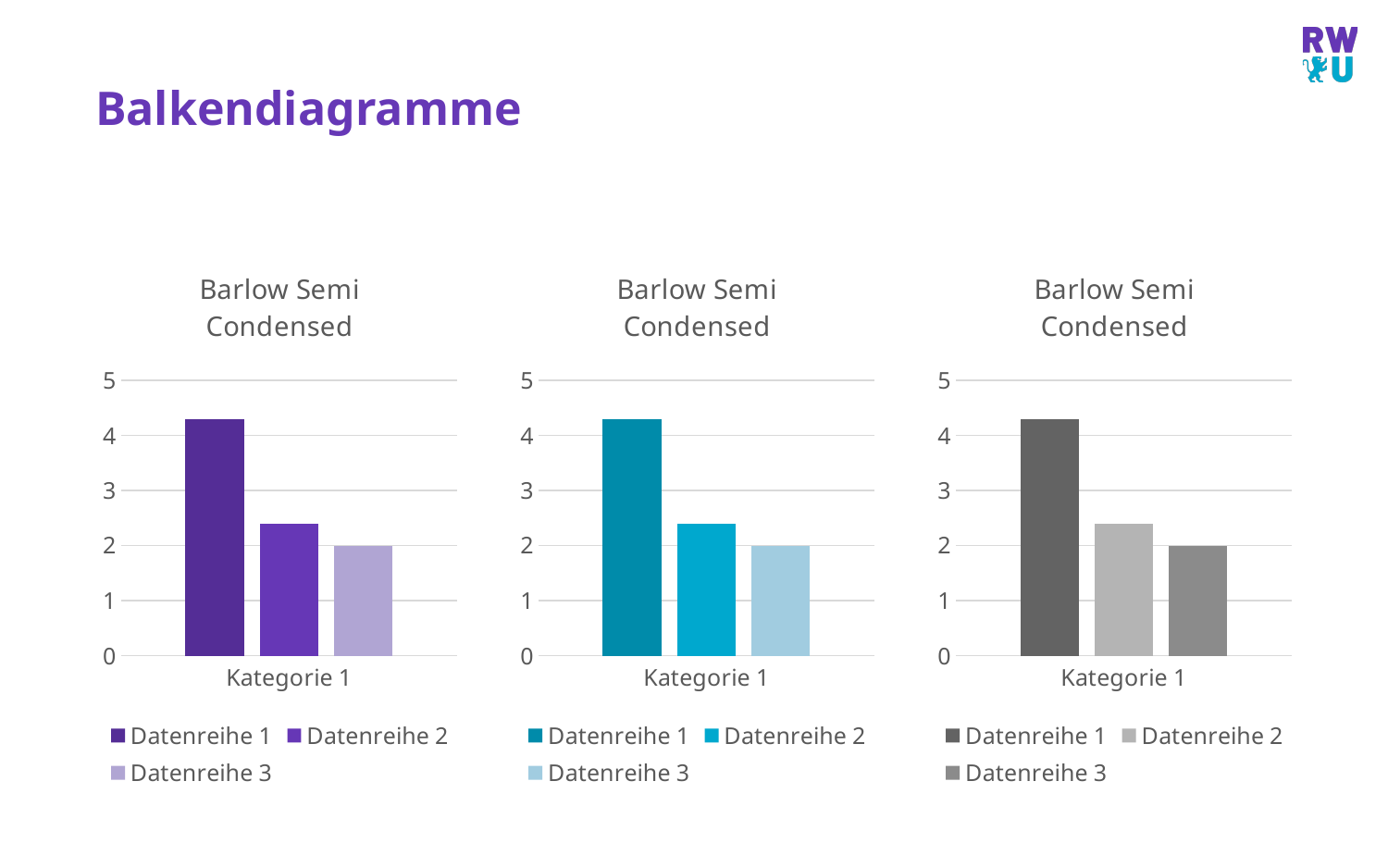
In the middle chart, which series has the lowest value for Kategorie 1? Datenreihe 3 In the left chart, which series has the highest value for Kategorie 1? Datenreihe 1 What kind of chart is the left chart on the slide? bar chart In the left chart, is the value for Datenreihe 2 greater or less than 3? less In the left chart, which is larger for Kategorie 1: Datenreihe 2 or Datenreihe 3? Datenreihe 2 What is the title of the middle chart? Barlow Semi Condensed How many categories are shown on the x axis of the right chart? 1 How many series does the legend of the middle chart list? 3 In the right chart, is the value for Datenreihe 1 greater or less than 4? greater In the right chart, which is larger for Kategorie 1: Datenreihe 1 or Datenreihe 2? Datenreihe 1 What is the category label on the x axis of the left chart? Kategorie 1 In the middle chart, what is the value for Datenreihe 3 in Kategorie 1? 2